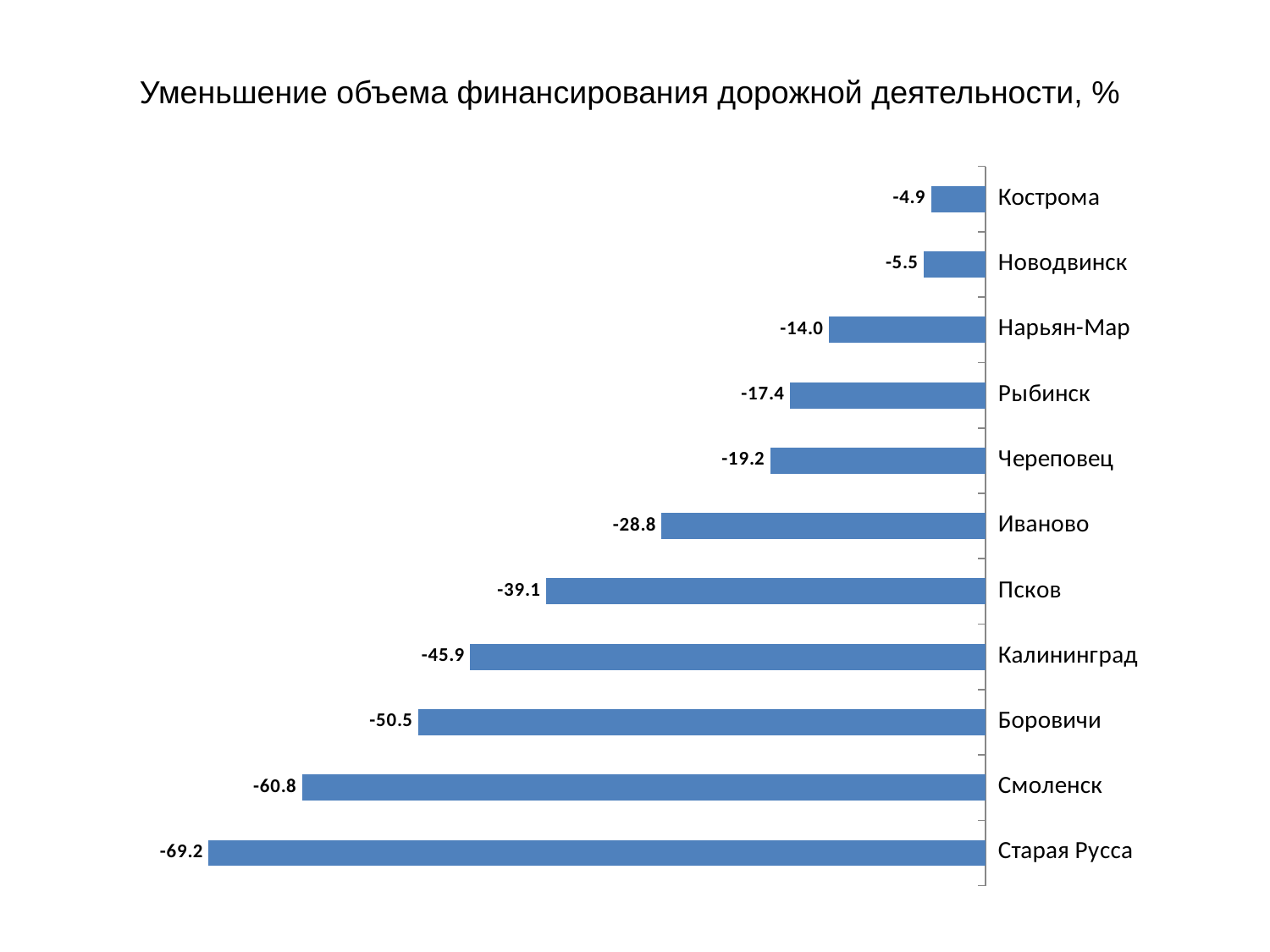
What is the title of the chart? Уменьшение объема финансирования дорожной деятельности, % Which city has the largest decrease (the longest bar)? Старая Русса What kind of chart is shown on the slide? Bar chart What is the value for Нарьян-Мар? -14.0 What is the value for Смоленск? -60.8 What is the difference between the values for Старая Русса and Смоленск? 8.4 What is the value for Псков? -39.1 What is the difference between the values for Калининград and Иваново? 17.1 Which city has the smallest decrease (the shortest bar)? Кострома What is the value for Череповец? -19.2 Which has a larger decrease, Боровичи or Рыбинск? Боровичи How many cities are shown in the chart? 11